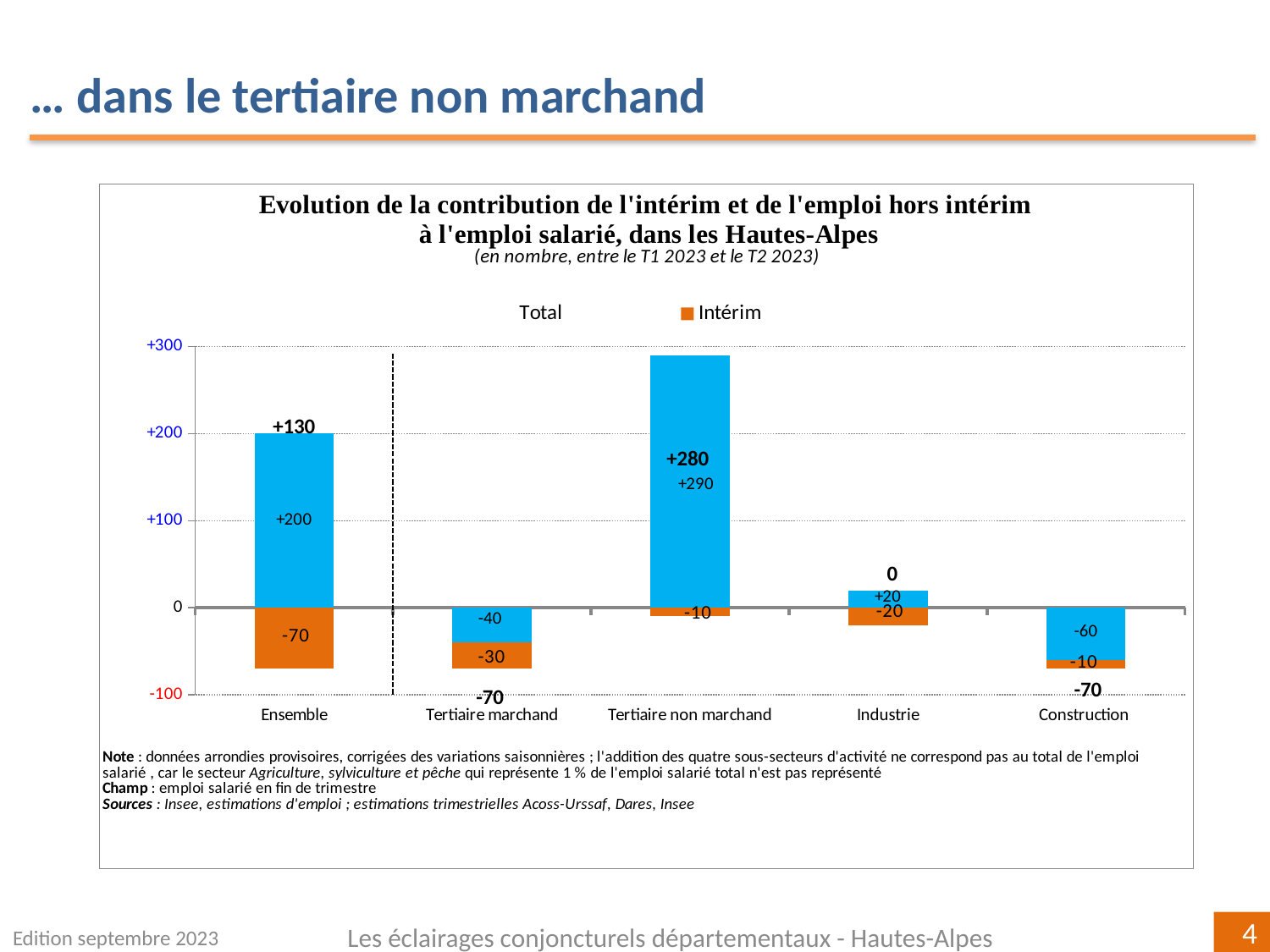
How many categories are shown on the x axis of the chart? 5 What is the difference between the blue value for Tertiaire non marchand (+290) and the blue value for Ensemble (+200)? 90 What is the Intérim value for Industrie? -20 What is the Intérim value for Ensemble? -70 Which is larger: the Intérim value for Tertiaire marchand or the Intérim value for Construction? Construction What is the total (bold label) for Tertiaire marchand? -70 What is the blue (non-Intérim) value for Tertiaire non marchand? +290 Which category has the lowest Intérim value? Ensemble Which category has the highest total? Tertiaire non marchand How many series does the legend list? 2 What is the total (bold label) for Industrie? 0 What type of chart is shown on the slide? bar chart